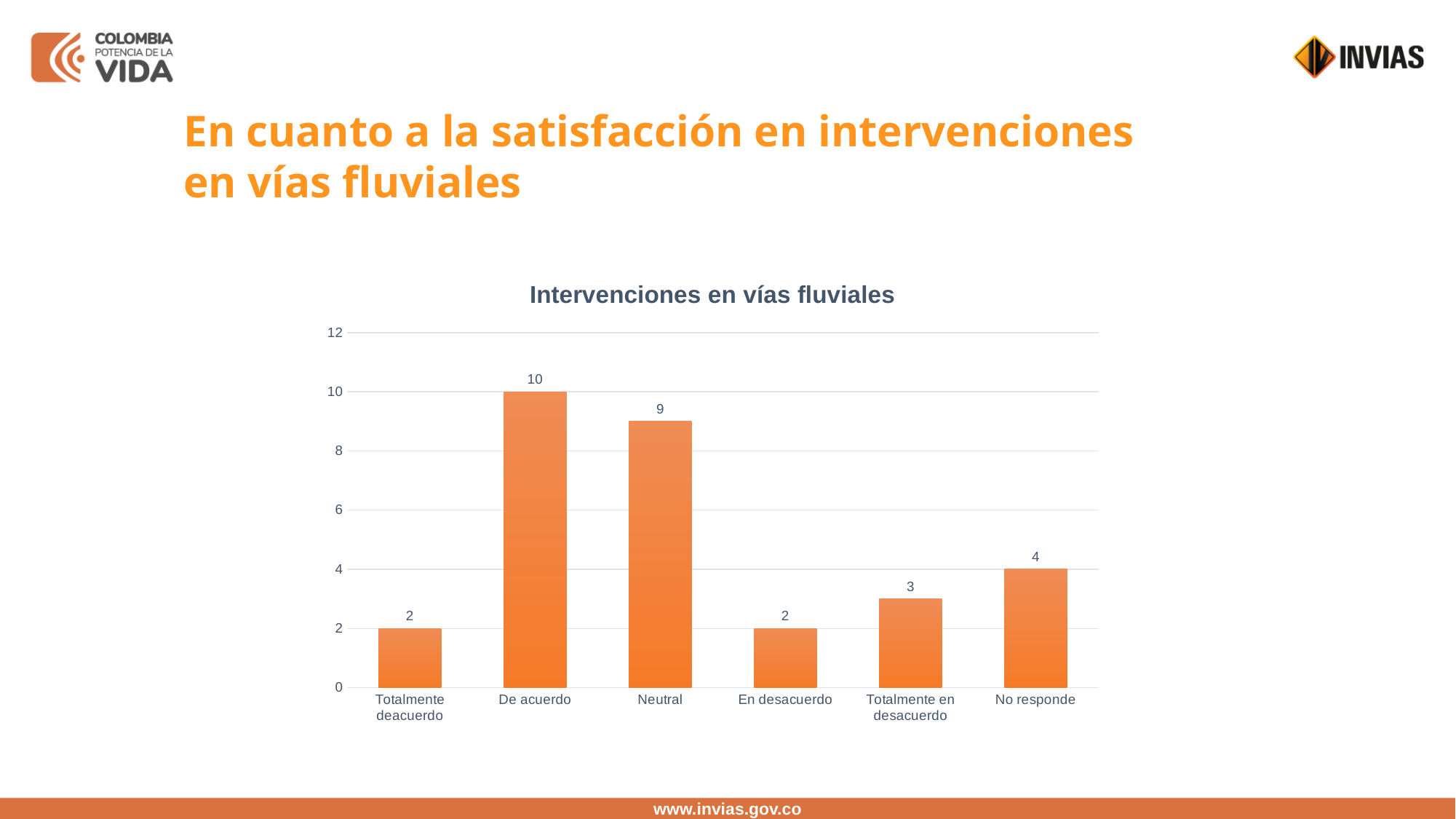
Is the value for De acuerdo greater or less than 8? greater Which category has the highest value? De acuerdo What is the value for Totalmente en desacuerdo? 3 What is the difference between the values for No responde and Totalmente en desacuerdo? 1 What is the difference between the values for De acuerdo and Neutral? 1 What kind of chart is shown? bar chart What is the title of the chart? Intervenciones en vías fluviales What is the value for Neutral? 9 Which is larger, the value for Neutral or the value for No responde? Neutral How many categories are shown on the x axis? 6 What is the value for De acuerdo? 10 What is the value for No responde? 4